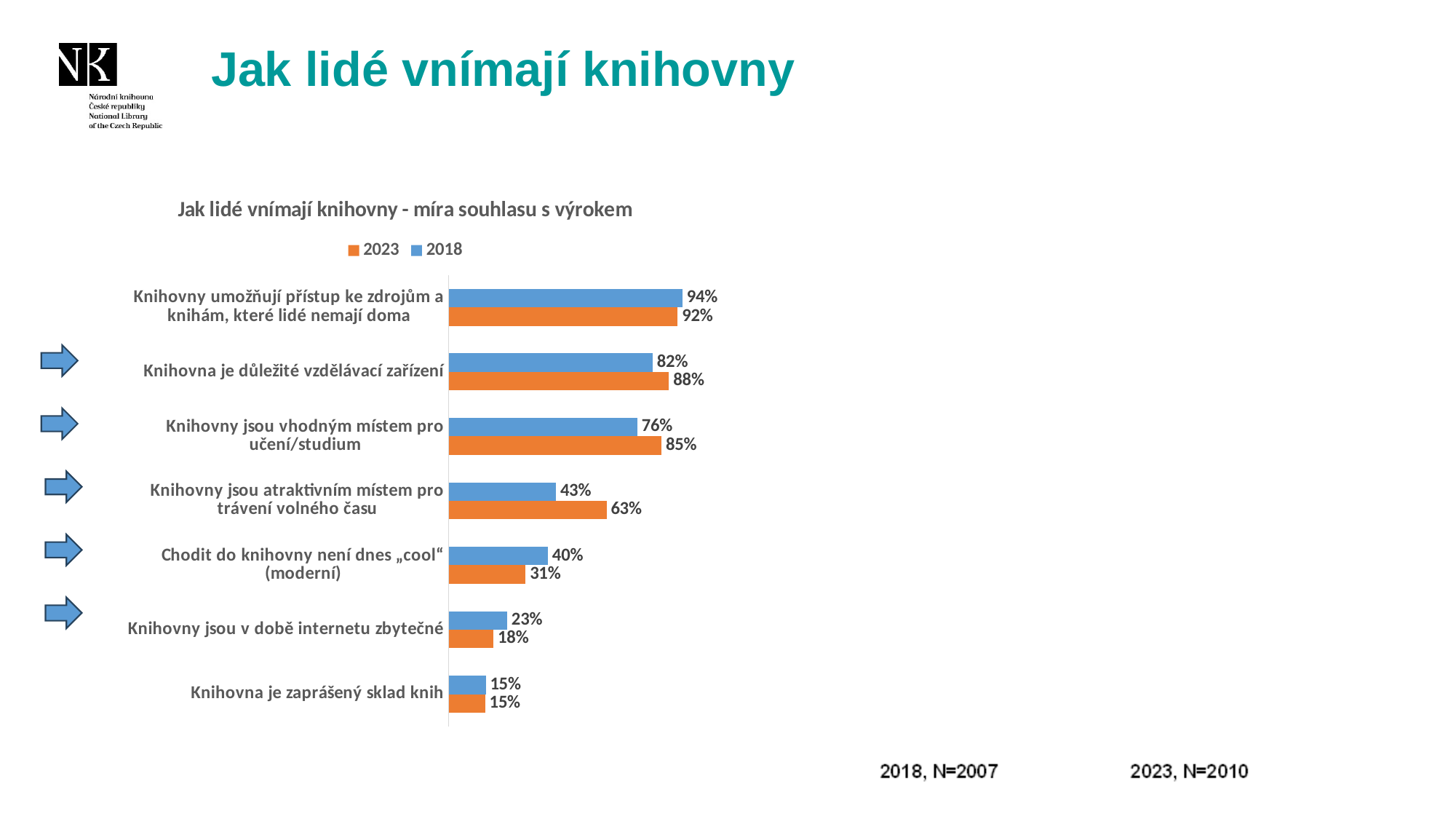
What is the 2018 value for "Knihovna je důležité vzdělávací zařízení"? 82% How many statements (categories) are shown in the chart? 7 Which statement has the lowest 2023 value? Knihovna je zaprášený sklad knih For "Knihovny jsou vhodným místem pro učení/studium", which year has the larger value, 2018 or 2023? 2023 How many series does the legend list? 2 What is the title of the chart? Jak lidé vnímají knihovny - míra souhlasu s výrokem Which statement has the highest 2018 value? Knihovny umožňují přístup ke zdrojům a knihám, které lidé nemají doma What is the 2023 value for "Knihovny jsou v době internetu zbytečné"? 18% What is the 2023 value for "Knihovny jsou atraktivním místem pro trávení volného času"? 63% What is the difference between the 2023 and 2018 values for "Knihovny jsou atraktivním místem pro trávení volného času"? 20 percentage points What type of chart is shown on the slide? Bar chart What is the difference between the 2018 and 2023 values for "Chodit do knihovny není dnes „cool“ (moderní)"? 9 percentage points